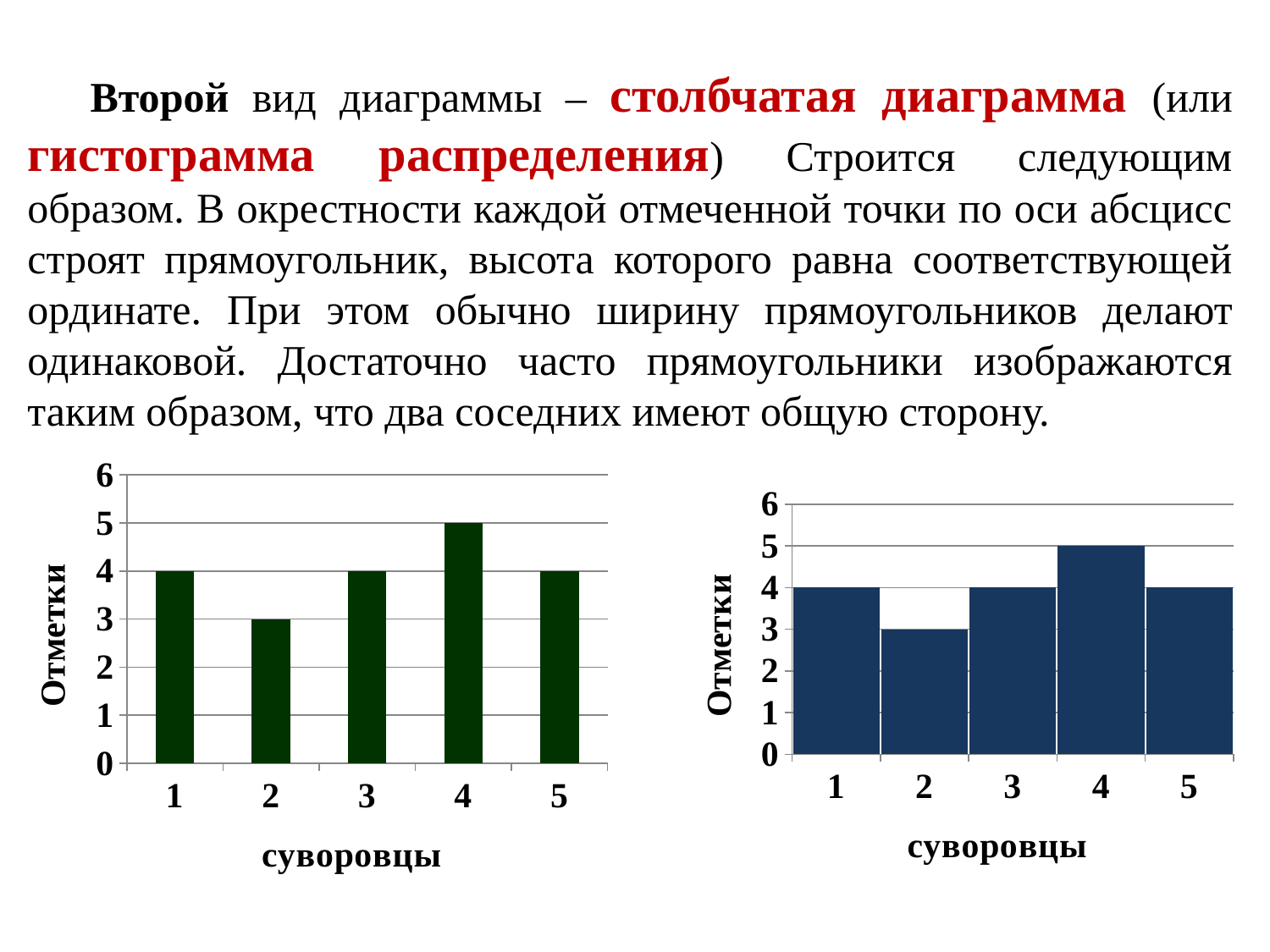
In the left chart, which суворовец has the highest mark? 4 What kind of chart is the right chart? bar chart In the right chart, which суворовец has the lowest mark? 2 In the right chart, what is the total of the values for all five суворовцы? 20 In the right chart, which is larger: the value for суворовец 3 or суворовец 4? суворовец 4 What is the label of the horizontal axis on the right chart? суворовцы In the left chart, what is the value for суворовец 4? 5 In the left chart, what is the difference between the values for суворовец 4 and суворовец 2? 2 What is the label of the vertical axis on the left chart? Отметки In the right chart, what is the value for суворовец 1? 4 How many categories are shown on the x axis of the left chart? 5 In the left chart, what is the value for суворовец 2? 3